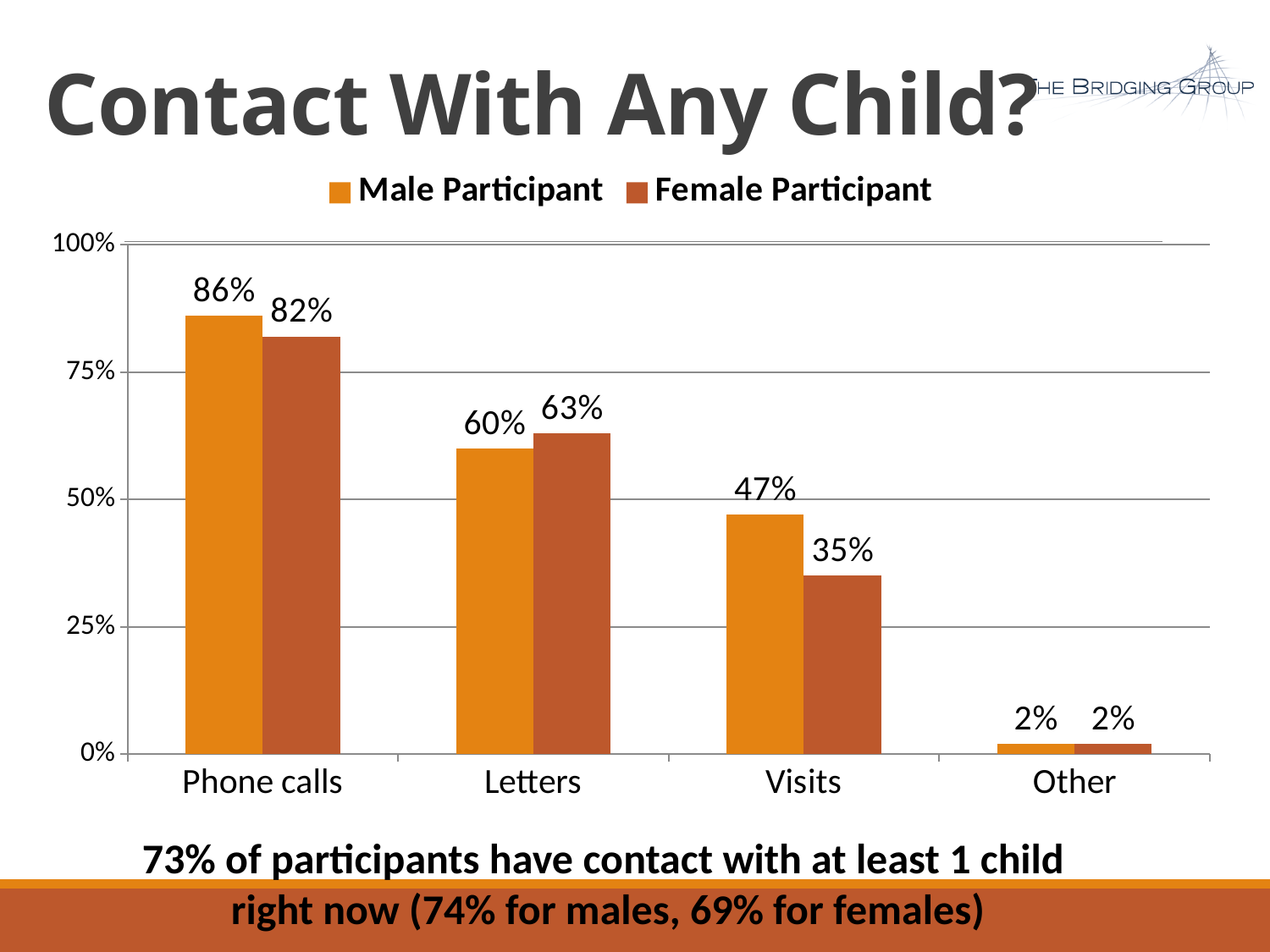
Do the Male Participant values rise or fall from Phone calls to Other? fall How many categories are shown on the x axis? 4 Which category has the lowest value for Female Participant? Other Is the Male Participant value for Visits greater or less than 50%? less What is the value for Female Participant for Visits? 35% What is the value for Male Participant for Phone calls? 86% For Letters, which is larger: the Male Participant value or the Female Participant value? Female Participant What is the value for Female Participant for Letters? 63% Which category has the highest value for Male Participant? Phone calls How many series does the legend list? 2 What kind of chart is shown on the slide? bar chart What is the difference between the Male Participant and Female Participant values for Visits? 12%